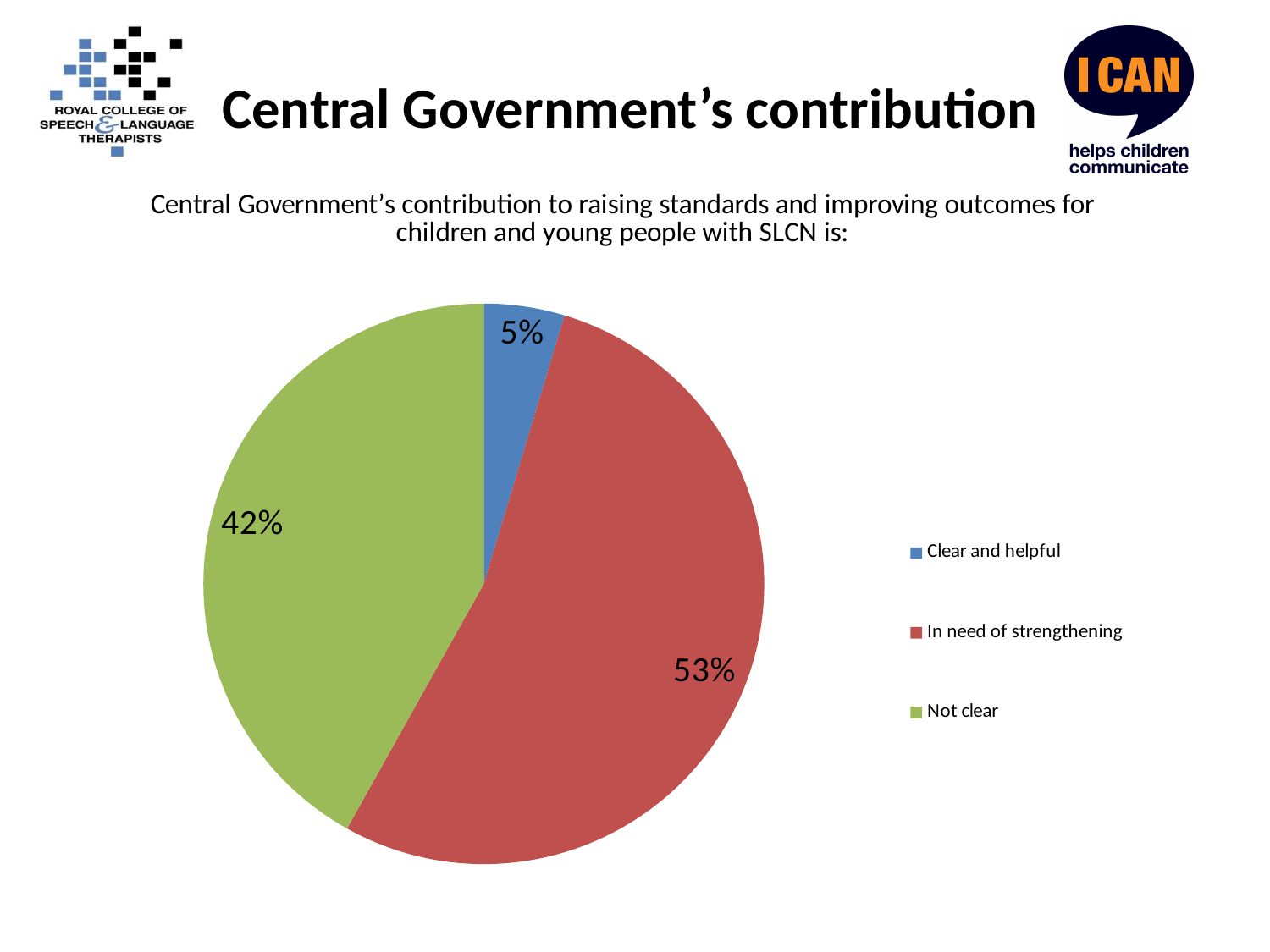
What colour is the 'In need of strengthening' slice in the pie chart? Red Which category has the smallest share of the pie chart? Clear and helpful What kind of chart is shown on the slide? Pie chart What is the difference in percentage points between 'In need of strengthening' and 'Not clear'? 11 Which is larger: the share for 'Not clear' or the share for 'Clear and helpful'? Not clear Which category has the largest share of the pie chart? In need of strengthening What percentage of the pie chart is 'In need of strengthening'? 53% What percentage of the pie chart is 'Not clear'? 42% What colour is the 'Not clear' slice in the pie chart? Green What is the difference in percentage points between 'Not clear' and 'Clear and helpful'? 37 What percentage of the pie chart is 'Clear and helpful'? 5% How many categories does the pie chart show? 3